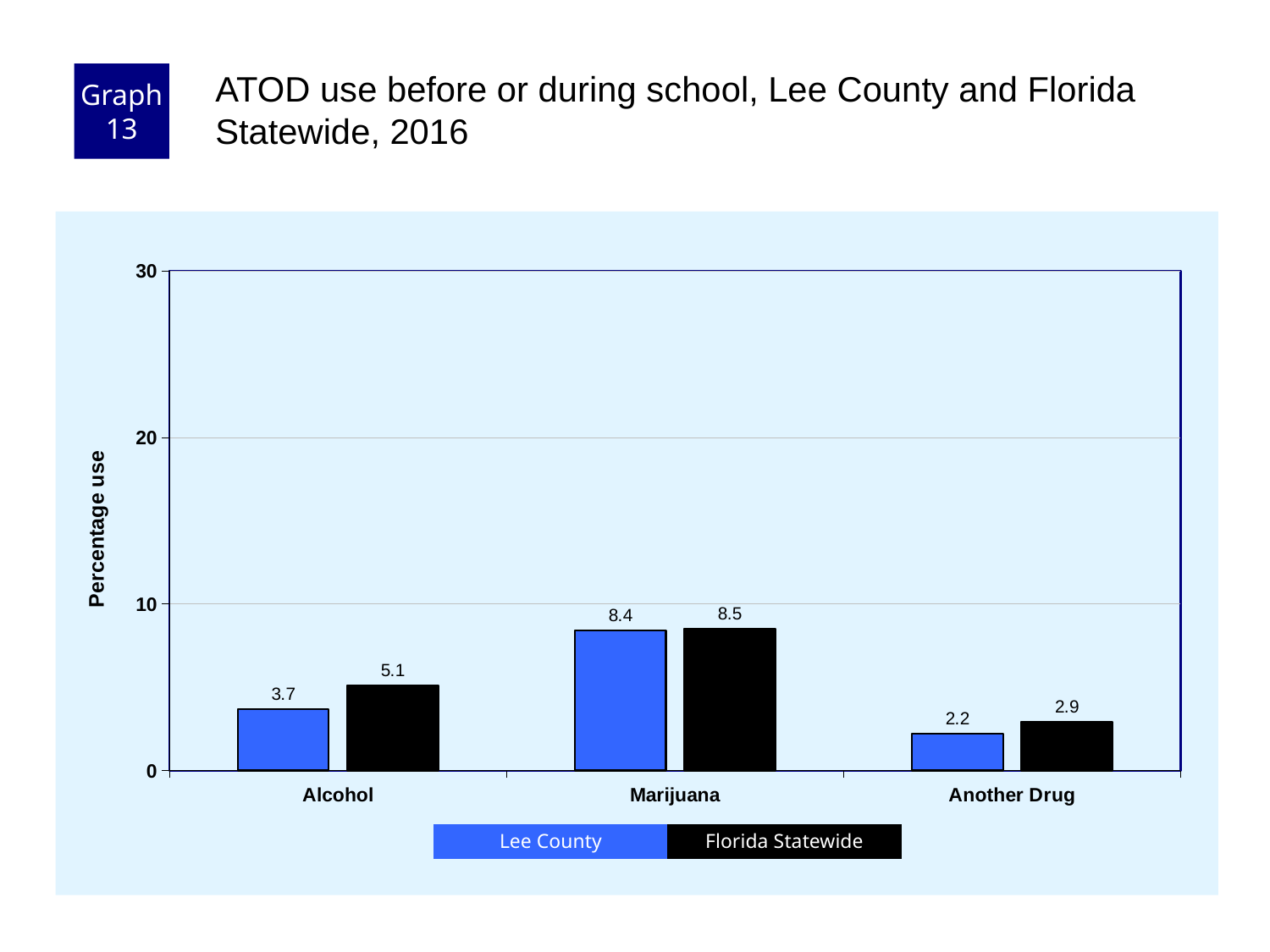
What kind of chart is shown? bar chart How many series does the legend list? 2 What is the difference between the Florida Statewide and Lee County values for Alcohol? 1.4 What is the Lee County value for Alcohol? 3.7 Which category has the highest Lee County value? Marijuana What is the Florida Statewide value for Alcohol? 5.1 What is the Lee County value for Another Drug? 2.2 What is the Florida Statewide value for Marijuana? 8.5 How many categories are shown on the x axis? 3 Which category has the lowest Florida Statewide value? Another Drug Is the Florida Statewide value for Marijuana greater or less than 10? less Which is larger for Another Drug, Lee County or Florida Statewide? Florida Statewide